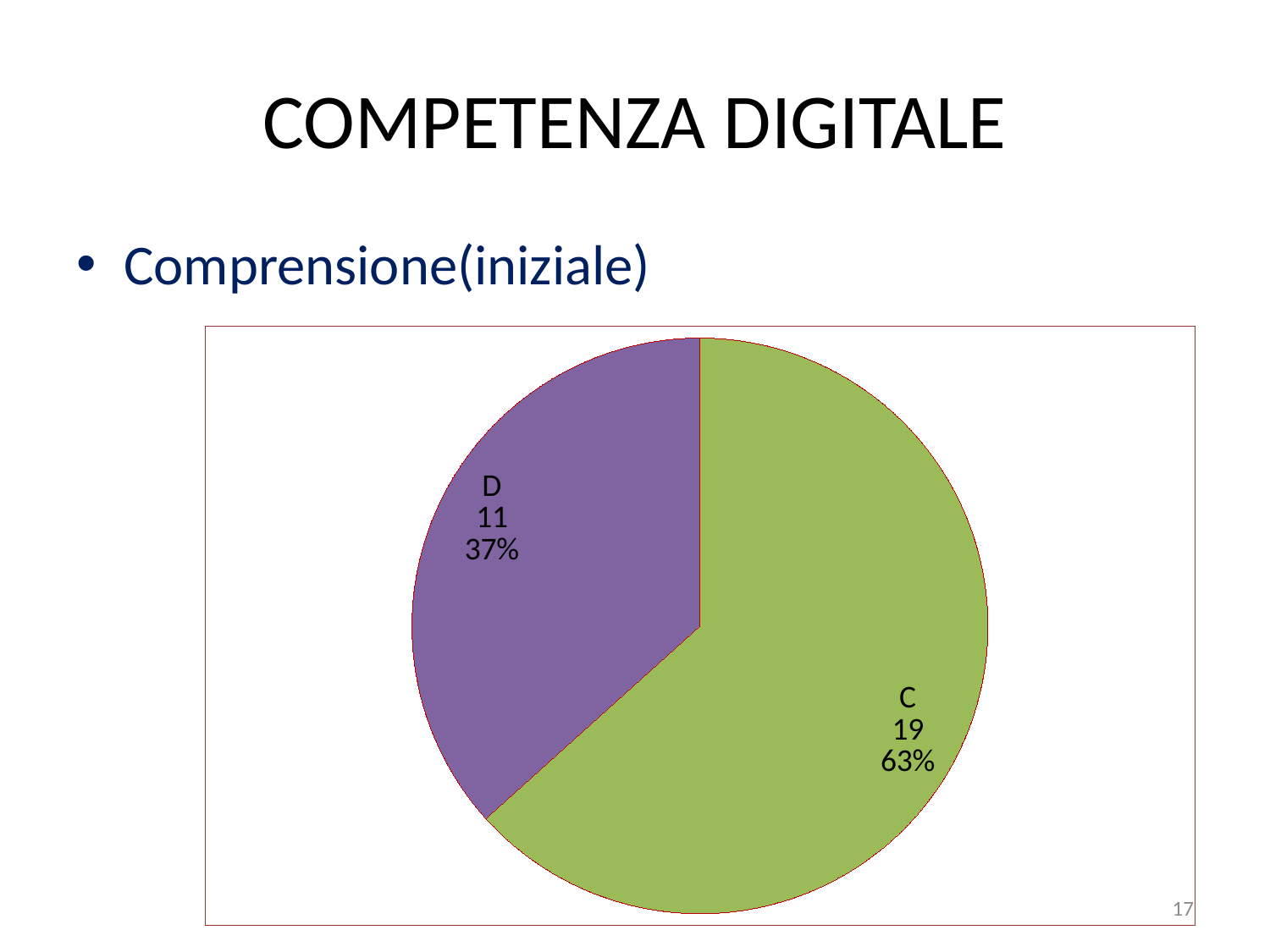
What is the value for category D? 11 What kind of chart is shown on the slide? pie chart How many slices does the pie chart have? 2 What is the total of the values shown in the pie chart? 30 What is the difference between the values for C and D? 8 What share of the pie does slice D represent? 37% What is the value for category C? 19 Which is larger, the value for C or the value for D? C Which category has the smallest slice? D What colour is the slice for category D? purple What share of the pie does slice C represent? 63% Which category has the largest slice? C